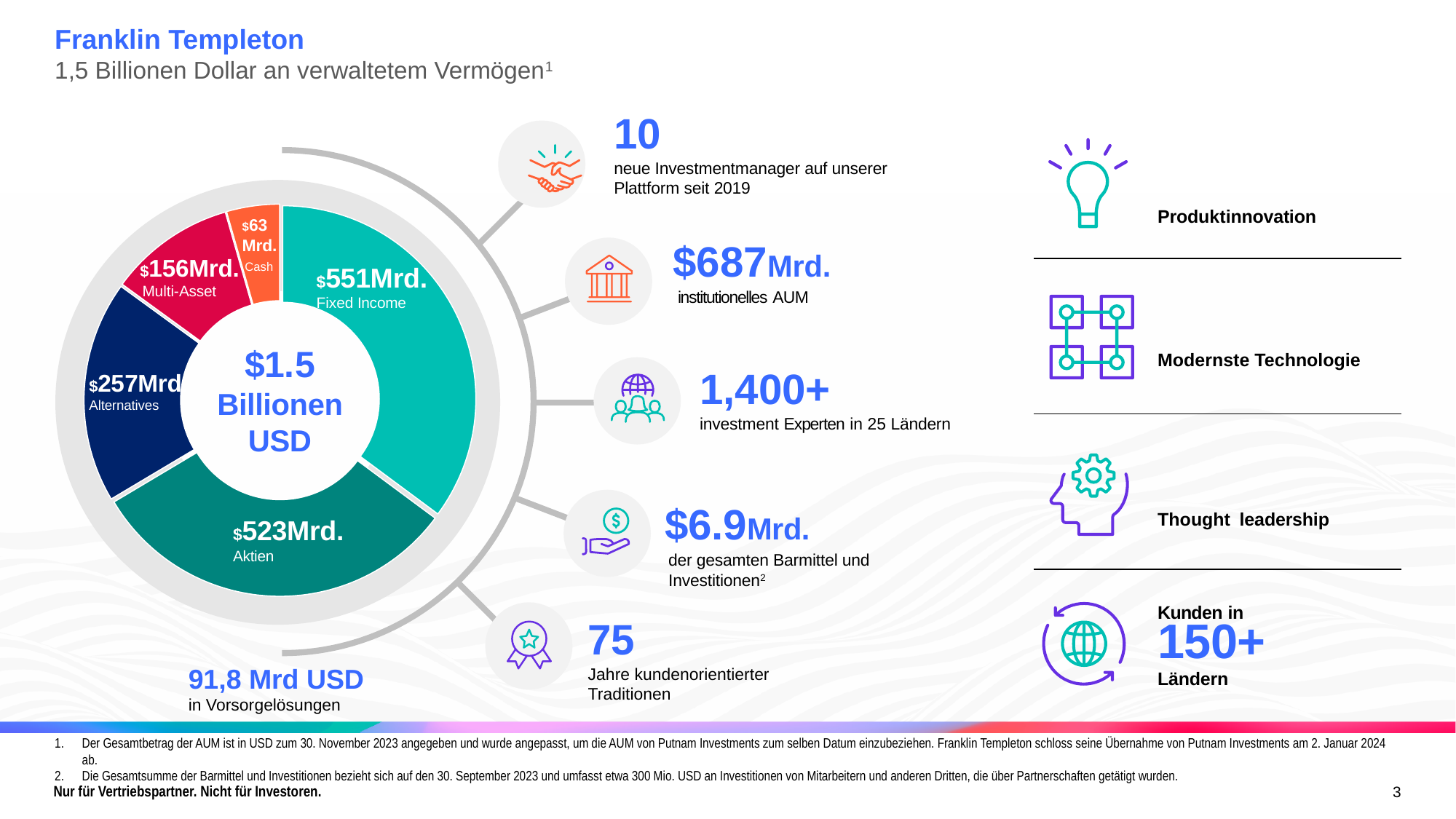
Which segment of the donut chart has the smallest value? Cash How many segments does the donut chart have? 5 What is the value shown for Cash in the donut chart? $63 Mrd. What type of chart is shown on the left of the slide? Pie (donut) chart What total value is displayed in the center of the donut chart? $1.5 Billionen USD What is the difference between the Multi-Asset and Cash values in the donut chart? $93 Mrd. Which segment of the donut chart has the largest value? Fixed Income What is the value shown for Aktien in the donut chart? $523Mrd. In the donut chart, which is larger: Aktien or Alternatives? Aktien What is the value shown for Fixed Income in the donut chart? $551Mrd. What is the difference between the Fixed Income and Aktien values in the donut chart? $28 Mrd. What is the value shown for Multi-Asset in the donut chart? $156Mrd.